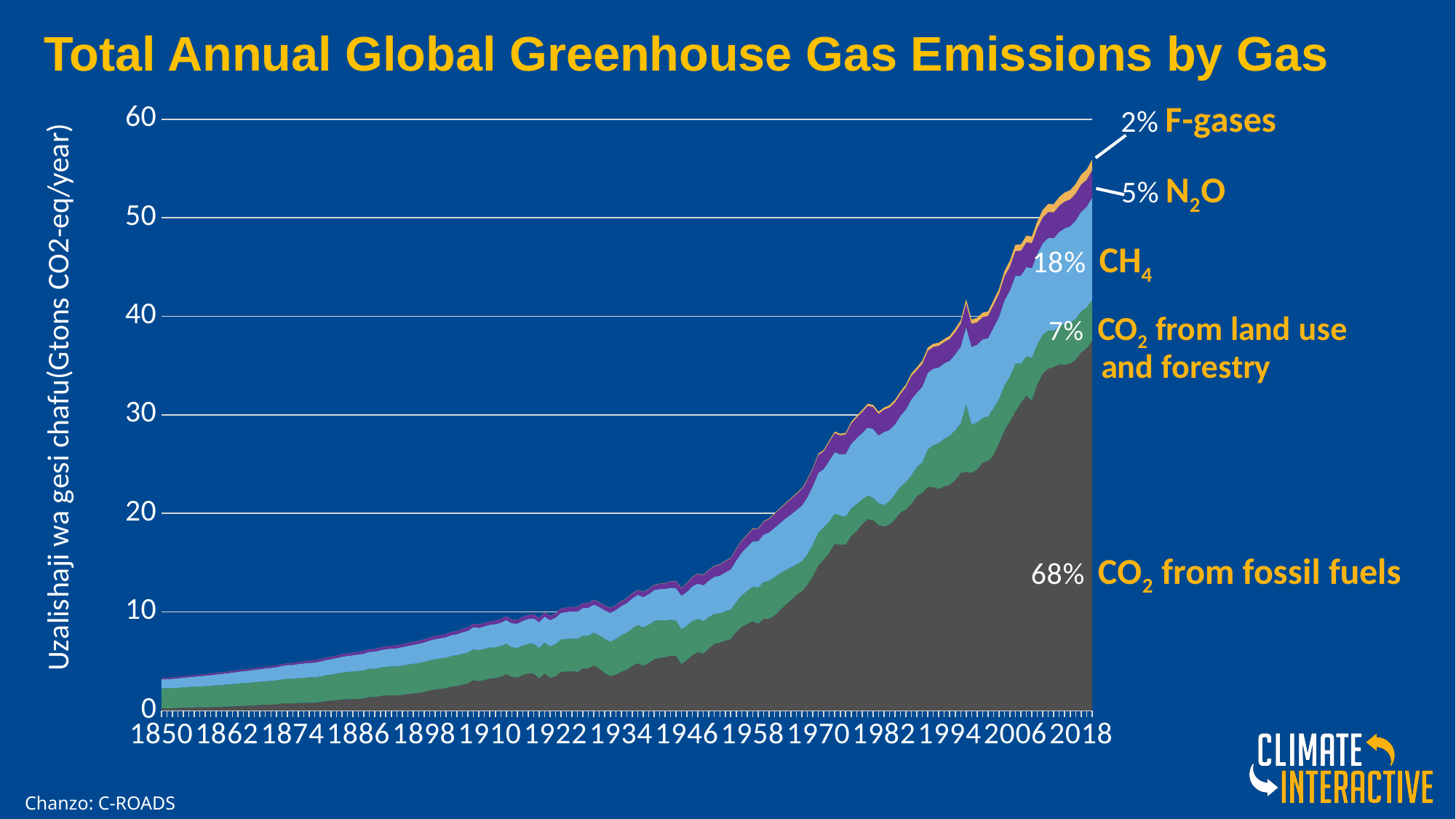
What is the difference between the labelled shares for CO2 from fossil fuels and CH4? 50% What kind of chart is shown on the slide? Stacked area chart Which gas has the smallest labelled share of emissions? F-gases What share of emissions is labelled for CH4? 18% What share of emissions is labelled for CO2 from land use and forestry? 7% Which gas has the largest labelled share of emissions? CO2 from fossil fuels How many gas categories are shown in the chart? 5 What share of emissions is labelled for N2O? 5% Is the total emissions value in 2018 greater or less than 50? greater Do total emissions rise or fall from 1850 to 2018? Rise What share of emissions is labelled for CO2 from fossil fuels? 68% Which has a larger labelled share, N2O or CO2 from land use and forestry? CO2 from land use and forestry